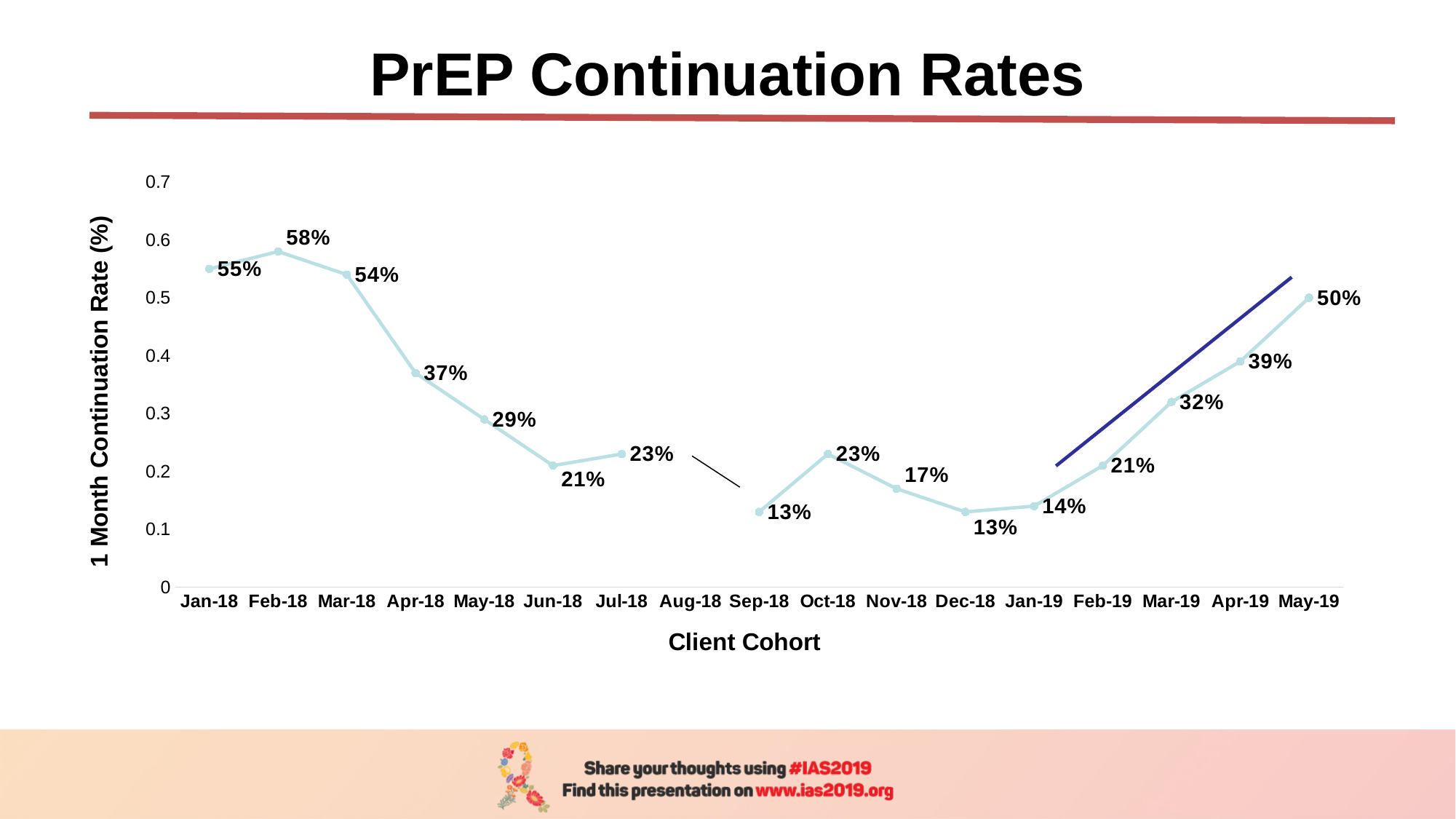
Which cohort has a higher continuation rate, Oct-18 or Nov-18? Oct-18 What is the 1 month continuation rate for the Mar-19 client cohort? 32% What is the 1 month continuation rate for the Sep-18 client cohort? 13% What is the 1 month continuation rate for the May-19 client cohort? 50% Which client cohort has the highest 1 month continuation rate? Feb-18 What kind of chart is shown on the slide? Line chart What is the 1 month continuation rate for the Feb-18 client cohort? 58% What is the difference between the continuation rates of the Jan-18 and Apr-18 cohorts? 18% Which cohort has a higher continuation rate, Mar-18 or Apr-19? Mar-18 How many client cohort labels are shown on the x axis? 17 What is the difference between the continuation rates of the May-19 and Jan-19 cohorts? 36% Do the continuation rates rise or fall from Jan-19 to May-19? Rise